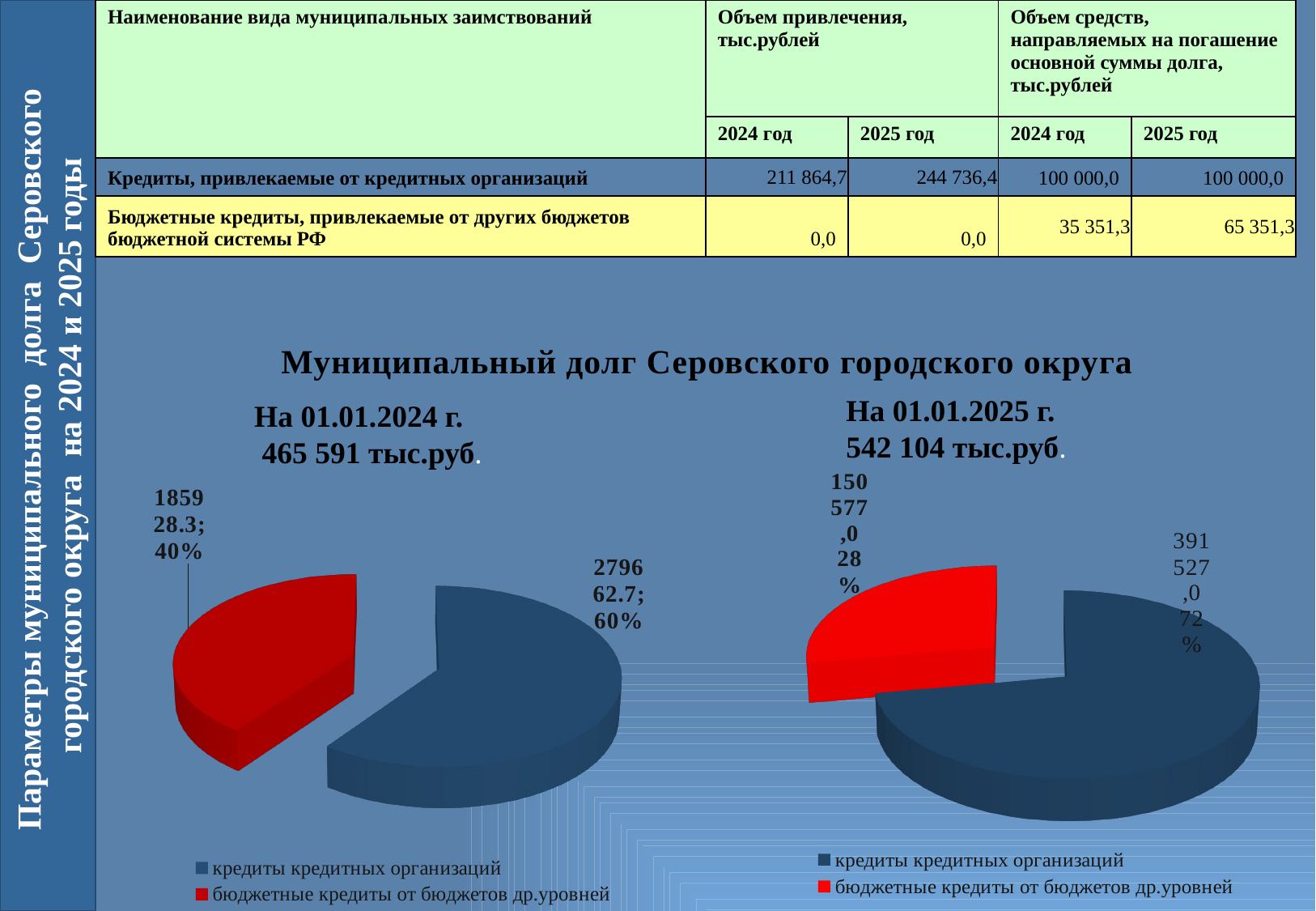
In the right chart (На 01.01.2025 г.), what is the value for 'бюджетные кредиты от бюджетов др.уровней'? 150 577,0 In the left chart (На 01.01.2024 г.), what share of the pie is 'бюджетные кредиты от бюджетов др.уровней'? 40% What kind of chart is used to show the municipal debt on 01.01.2024 (left chart)? pie chart In the right chart (На 01.01.2025 г.), what share of the pie is 'кредиты кредитных организаций'? 72% In the left chart (На 01.01.2024 г.), what share of the pie is 'кредиты кредитных организаций'? 60% What is the common title shown above the two pie charts? Муниципальный долг Серовского городского округа In the right chart (На 01.01.2025 г.), which category has the largest slice? кредиты кредитных организаций How many entries does the legend of the right chart (На 01.01.2025 г.) list? 2 In the right chart (На 01.01.2025 г.), what is the value for 'кредиты кредитных организаций'? 391 527,0 In the left chart (На 01.01.2024 г.), which slice is larger: 'кредиты кредитных организаций' or 'бюджетные кредиты от бюджетов др.уровней'? кредиты кредитных организаций In the right chart (На 01.01.2025 г.), what is the difference between the value for 'кредиты кредитных организаций' and the value for 'бюджетные кредиты от бюджетов др.уровней'? 240 950,0